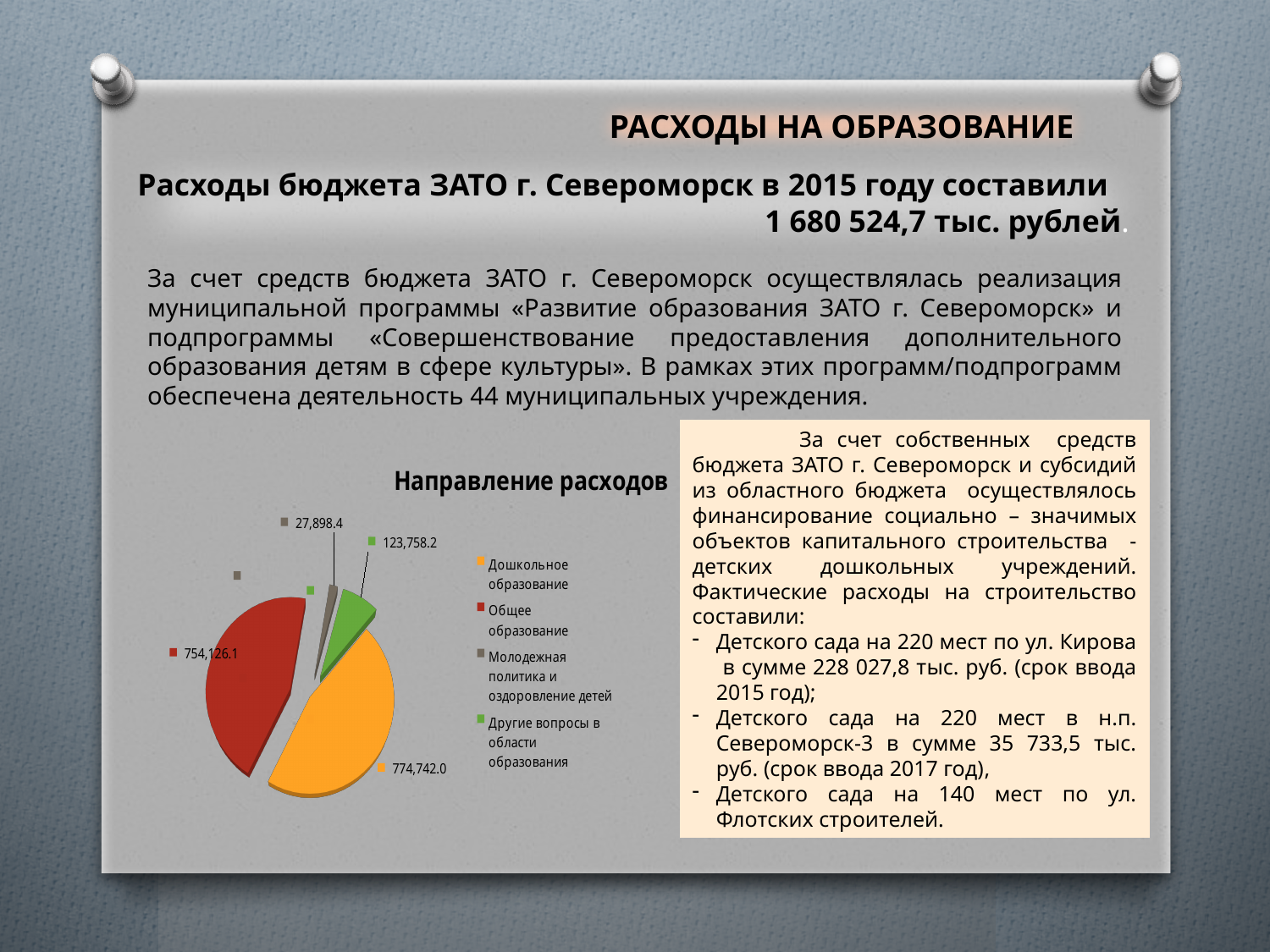
What colour is the slice for Общее образование? red What is the title of the chart? Направление расходов What is the difference between the values for Дошкольное образование and Общее образование? 20,615.9 Which is larger: Другие вопросы в области образования or Молодежная политика и оздоровление детей? Другие вопросы в области образования What is the value for Молодежная политика и оздоровление детей? 27,898.4 What is the value for Общее образование? 754,126.1 What is the value for Другие вопросы в области образования? 123,758.2 What is the value for Дошкольное образование? 774,742.0 How many categories does the pie chart show? 4 Which category has the smallest slice of the pie? Молодежная политика и оздоровление детей Which category has the largest slice of the pie? Дошкольное образование What type of chart is shown on the slide? pie chart